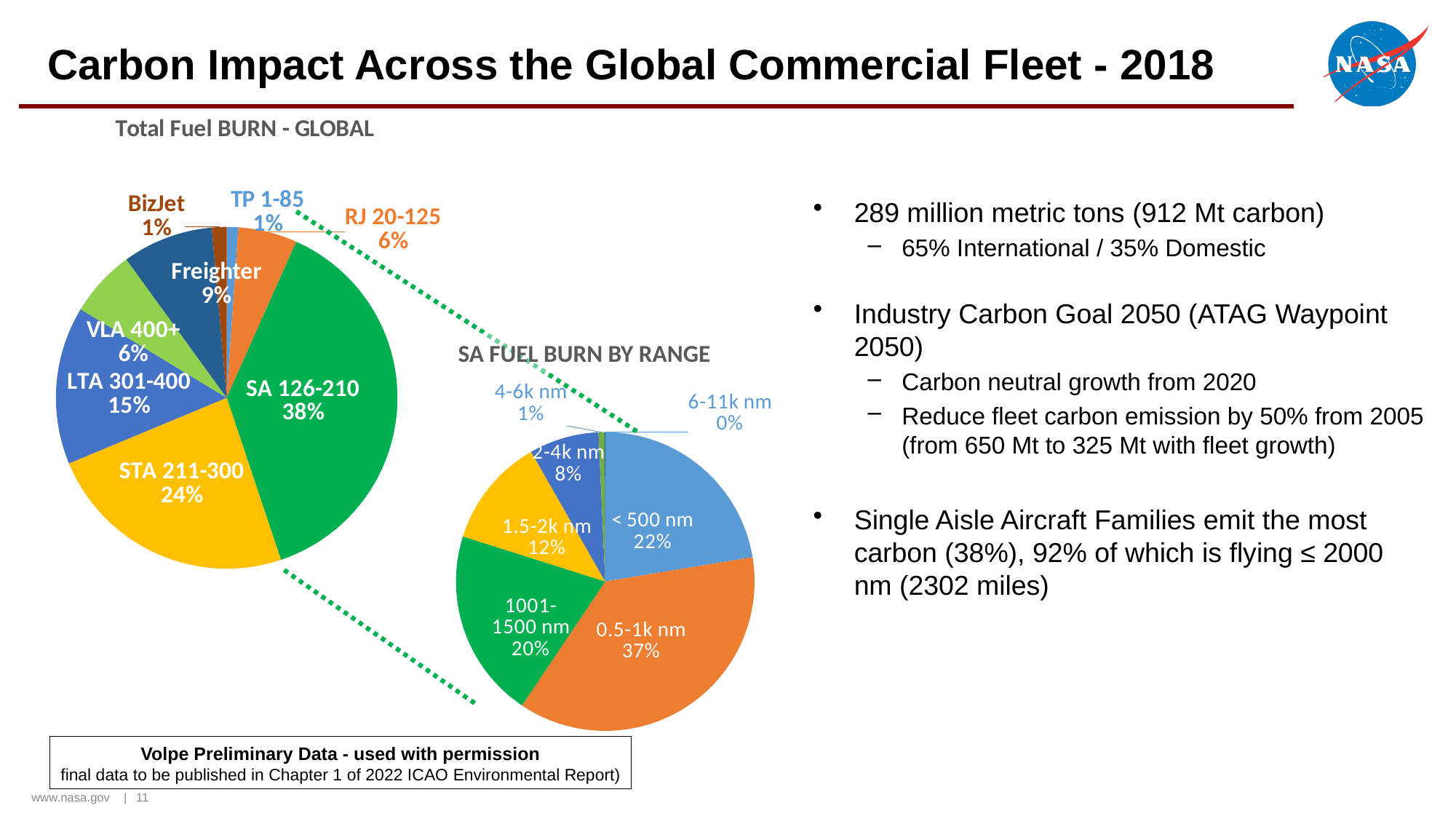
In the Total Fuel BURN - GLOBAL chart, which is larger, VLA 400+ or Freighter? Freighter In the Total Fuel BURN - GLOBAL chart, what share does SA 126-210 have? 38% In the SA FUEL BURN BY RANGE chart, what share does 0.5-1k nm have? 37% In the SA FUEL BURN BY RANGE chart, which range has the smallest share? 6-11k nm In the Total Fuel BURN - GLOBAL chart, which category has the largest share? SA 126-210 What type of chart is the Total Fuel BURN - GLOBAL chart? Pie chart How many categories are shown in the Total Fuel BURN - GLOBAL chart? 8 In the SA FUEL BURN BY RANGE chart, what share does 2-4k nm have? 8% How many range categories are shown in the SA FUEL BURN BY RANGE chart? 7 In the Total Fuel BURN - GLOBAL chart, what is the difference between the STA 211-300 share and the Freighter share? 15% In the SA FUEL BURN BY RANGE chart, what is the difference between the < 500 nm share and the 1001-1500 nm share? 2% In the Total Fuel BURN - GLOBAL chart, what share does LTA 301-400 have? 15%